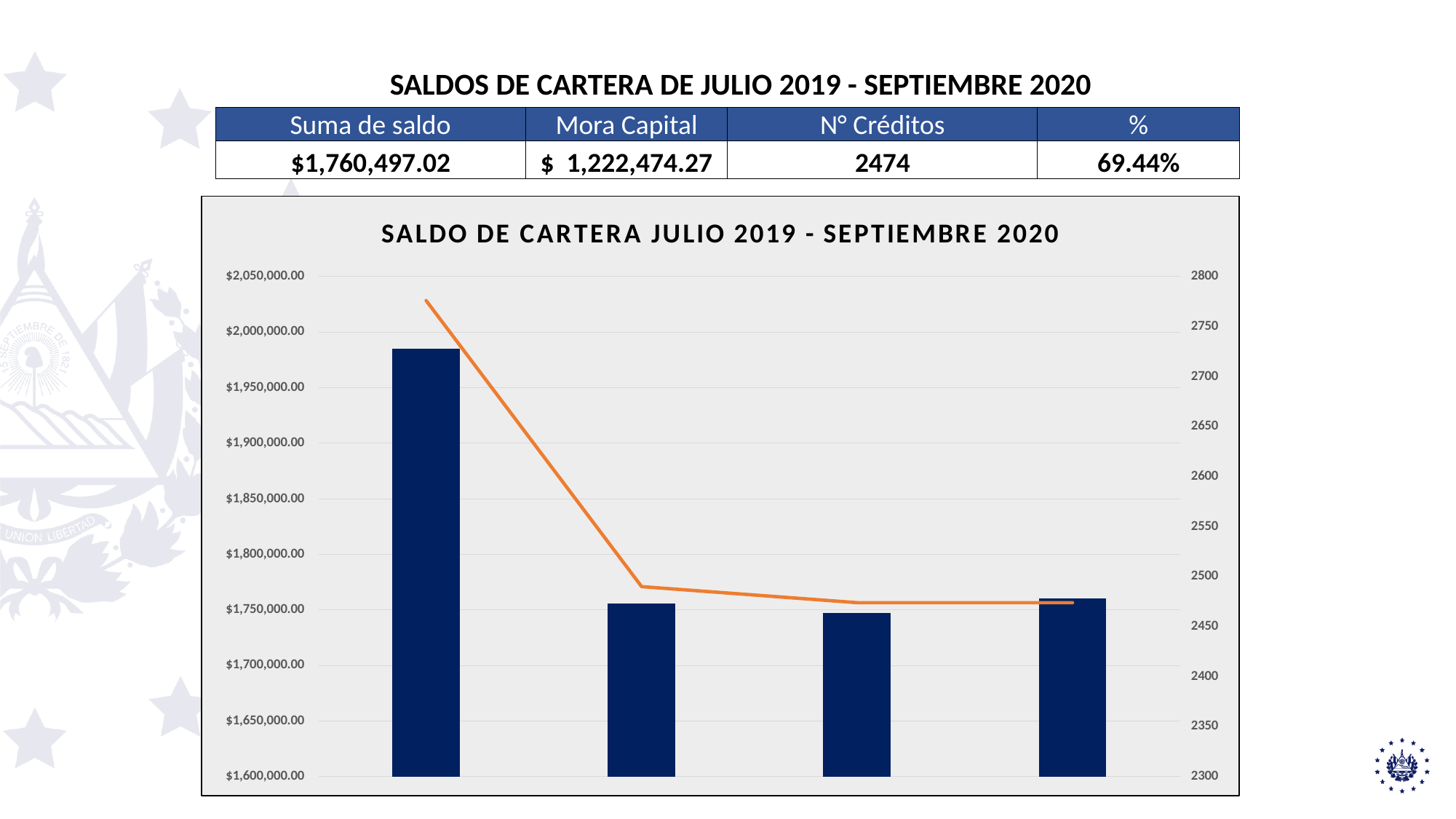
What colour is the line plotted in the chart? Orange On the right-hand axis, is the first point of the orange line greater or less than 2750? greater What kind of chart is shown on the slide? A bar chart combined with a line What is the title of the chart? SALDO DE CARTERA JULIO 2019 - SEPTIEMBRE 2020 Which is larger, the first bar from the left or the second bar from the left? The first bar from the left Is the value of the fourth bar from the left greater or less than $1,800,000.00? less Is the value of the second bar from the left greater or less than $1,800,000.00? less How many bars are plotted in the chart? 4 Does the orange line rise or fall from left to right across the chart? It falls Which bar is the tallest in the chart? The first bar from the left